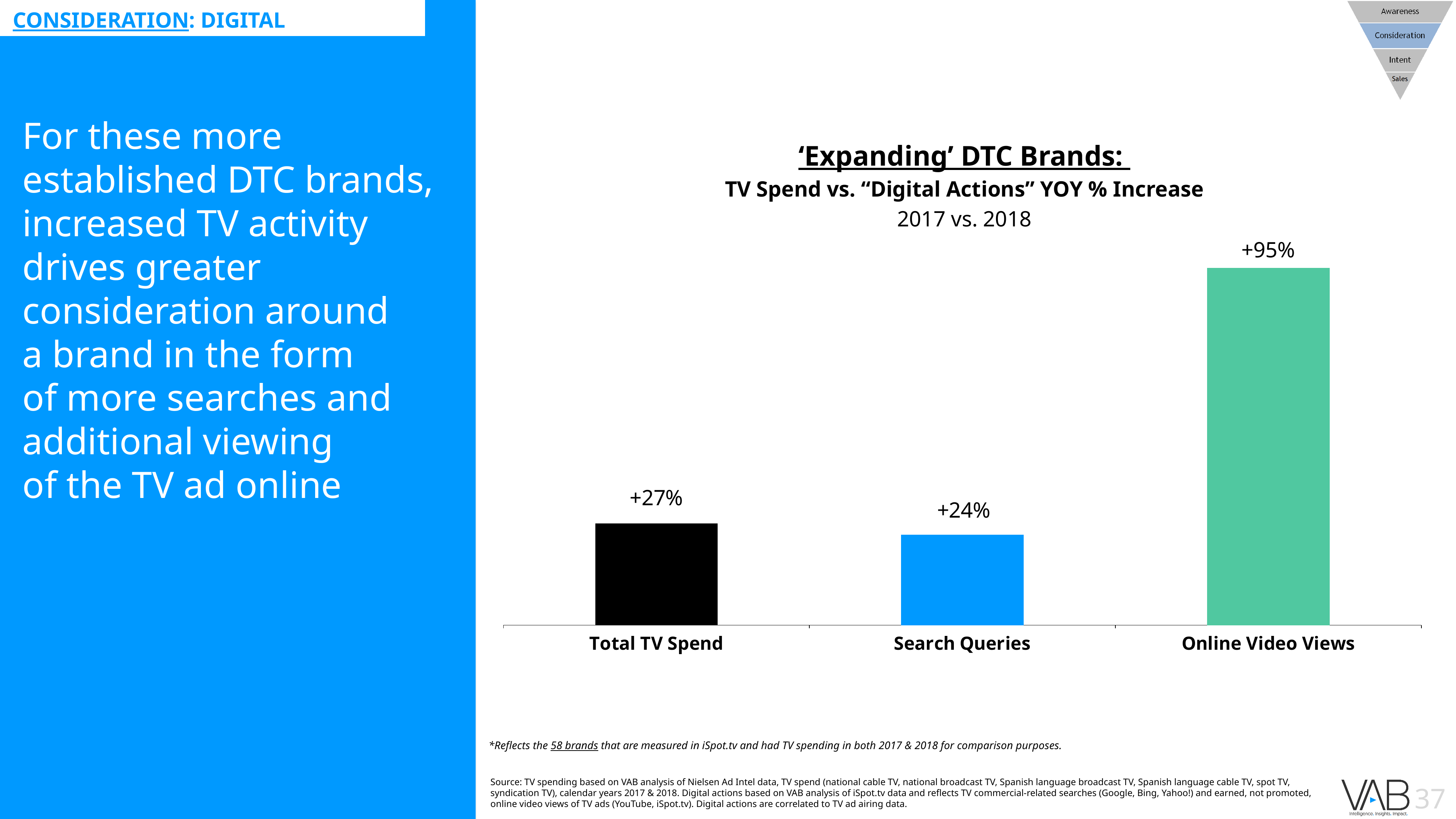
What two years does the chart compare? 2017 vs. 2018 What is the YOY % increase for Total TV Spend? +27% What is the YOY % increase for Online Video Views? +95% What kind of chart is shown on the slide? Bar chart What is the difference in percentage points between the Total TV Spend increase and the Search Queries increase? 3 percentage points Which category has the highest YOY % increase? Online Video Views What is the difference in percentage points between the Online Video Views increase and the Total TV Spend increase? 68 percentage points How many categories are shown in the chart? 3 Which category has the lowest YOY % increase? Search Queries Which is larger, the increase for Search Queries or the increase for Online Video Views? Online Video Views What is the YOY % increase for Search Queries? +24% What colour is the bar for Online Video Views? Green